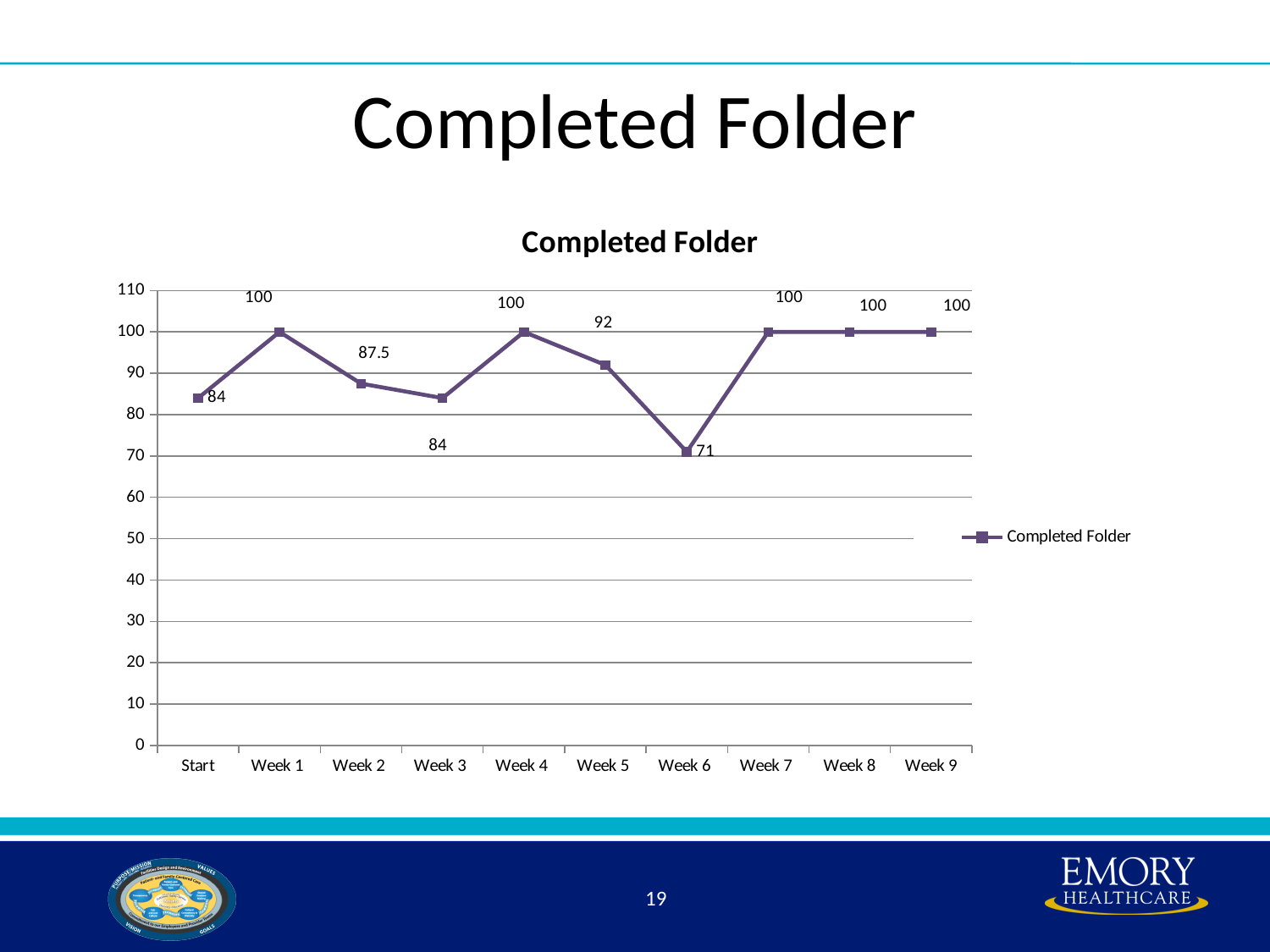
What is the value for Week 5? 92 What kind of chart is shown? line chart Which point has the lowest value? Week 6 Which is larger, the value for Week 3 or the value for Week 5? Week 5 How many points are plotted on the x axis? 10 What is the value at Start? 84 What is the difference between the values for Week 1 and Week 2? 12.5 What is the value for Week 6? 71 What is the difference between the values for Week 5 and Week 6? 21 How many series does the legend list? 1 Is the value for Week 6 greater or less than 80? less What is the value for Week 2? 87.5